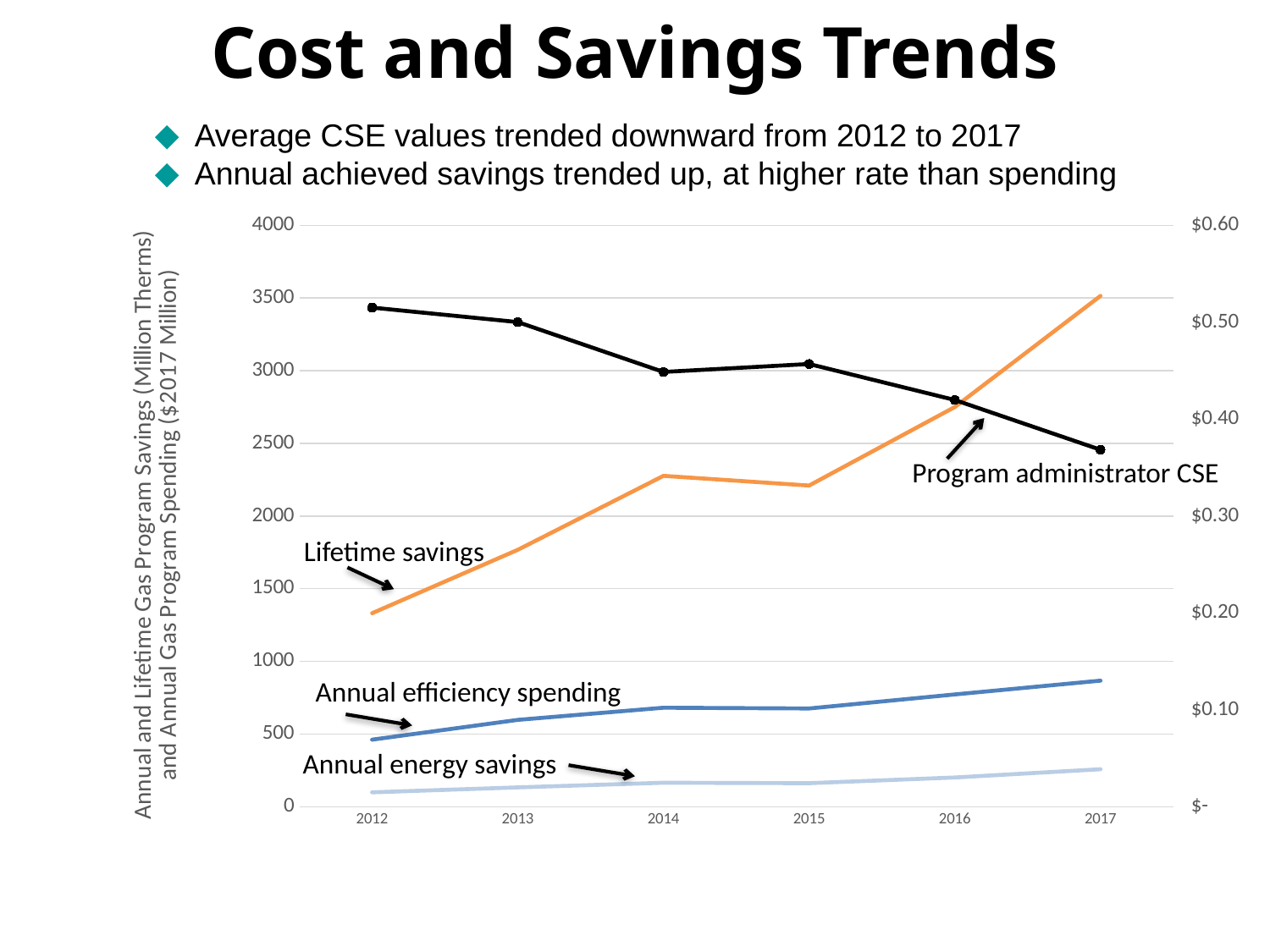
What kind of chart is shown on the slide? line chart Which series is drawn in orange on the chart? Lifetime savings Does the Program administrator CSE line rise or fall from 2012 to 2017? fall Is the value for Program administrator CSE in 2017 greater or less than $0.40? less Is the value for Annual efficiency spending in 2017 greater or less than 500? greater How many data series are labelled on the chart? 4 Is the value for Lifetime savings in 2012 greater or less than 1500? less Does the Lifetime savings line rise or fall from 2012 to 2017? rise In which year is Program administrator CSE lowest? 2017 In which year is Lifetime savings highest? 2017 How many years are plotted along the x axis of the chart? 6